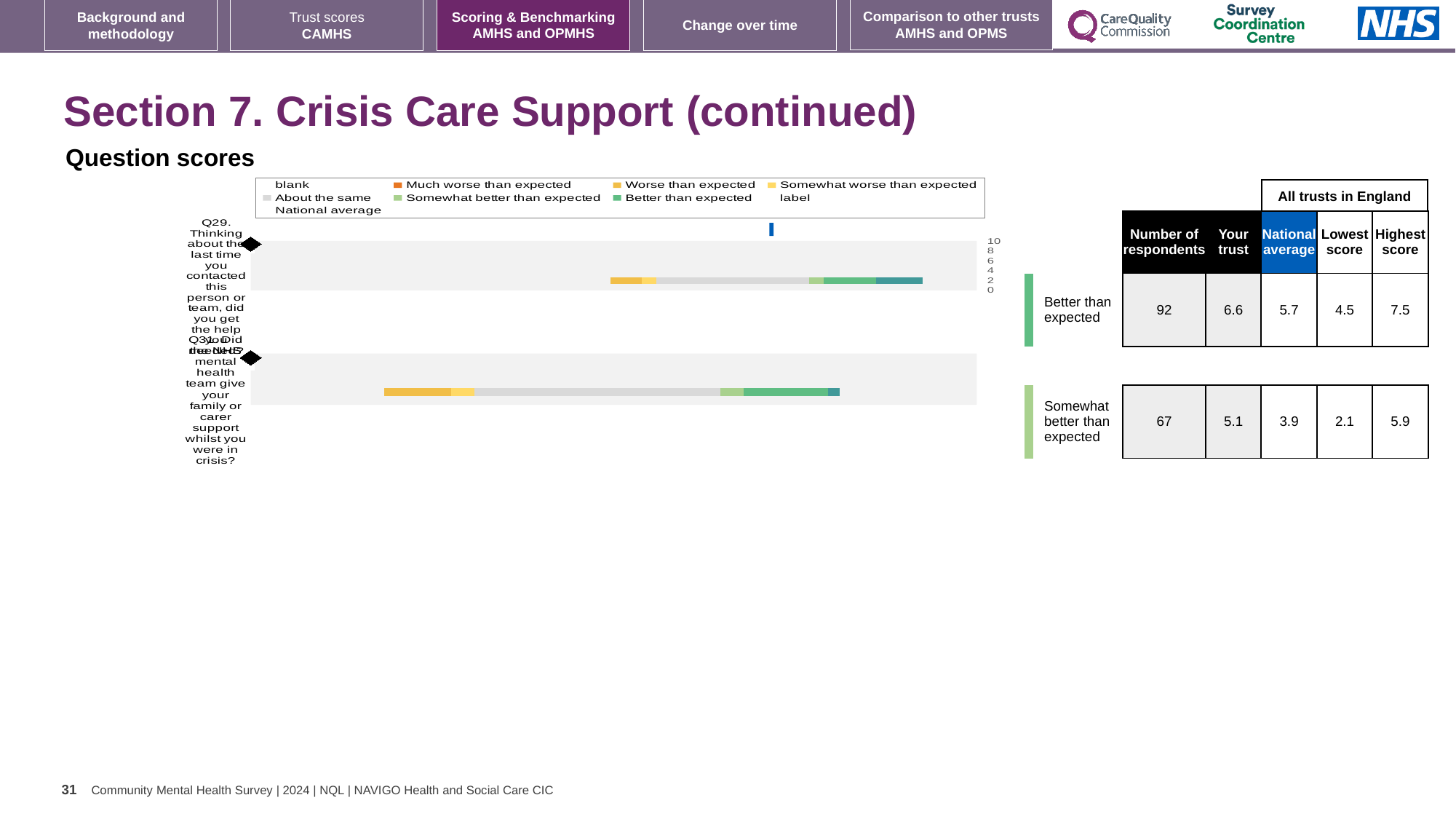
What kind of chart is used to show the question scores on this slide? bar chart In the table beside the chart, what is the 'Your trust' score for Q31? 5.1 For Q29, what is the difference between the highest score and the lowest score shown in the table? 3.0 What colour does the legend use for 'Better than expected'? green What is the heading above the question scores chart? Question scores How many questions are plotted as bars in the question scores chart? 2 Which benchmark category is Q31 rated as on this slide? Somewhat better than expected For Q29, which is larger: the 'Your trust' score or the national average? Your trust In the table beside the chart, what is the national average for Q29? 5.7 In the table beside the chart, what is the 'Your trust' score for Q29? 6.6 Which benchmark category is Q29 rated as on this slide? Better than expected In the table beside the chart, how many respondents answered Q31? 67